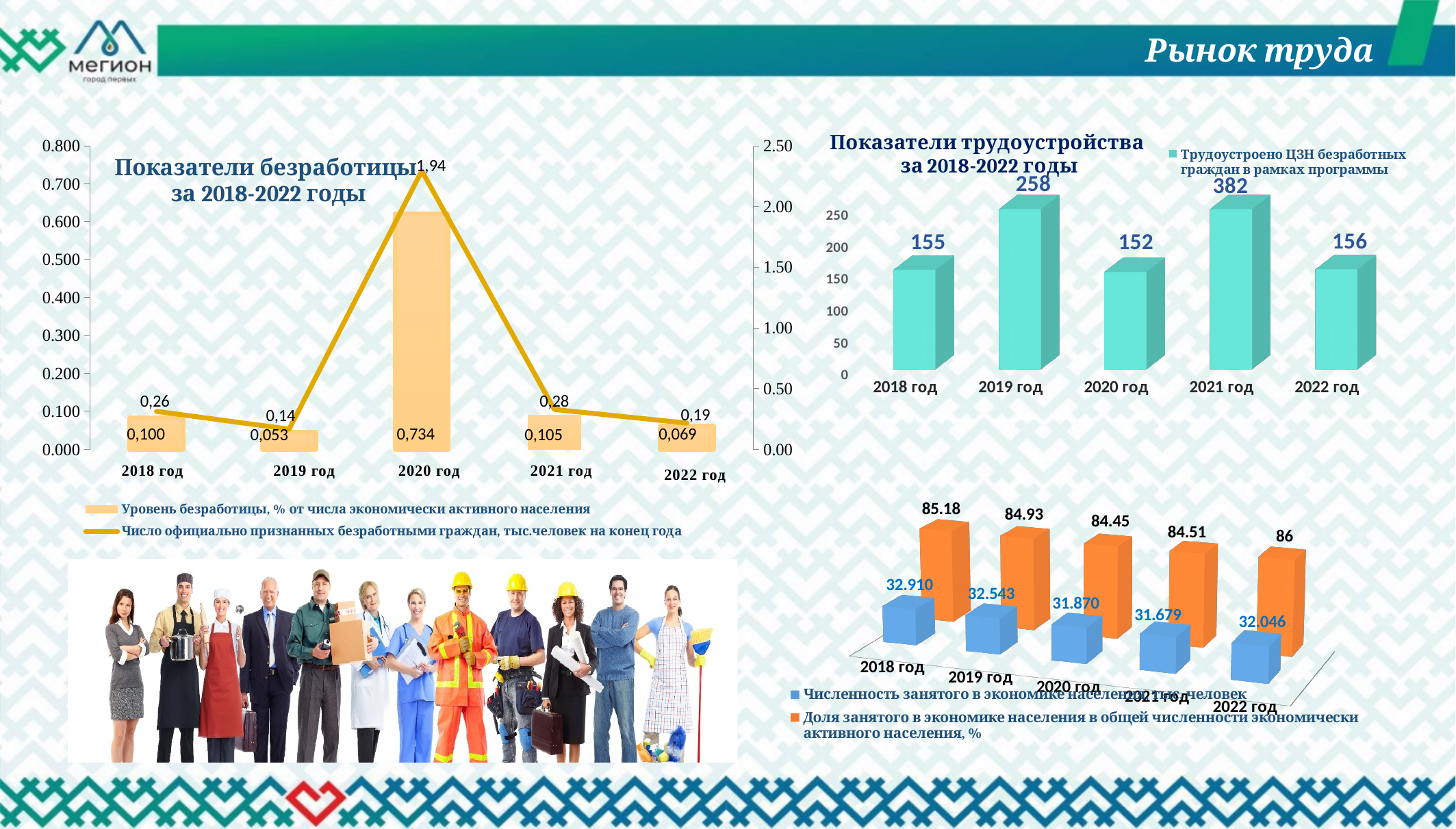
In the chart 'Показатели трудоустройства за 2018-2022 годы', how many years are shown on the x axis? 5 What kind of chart is 'Показатели трудоустройства за 2018-2022 годы'? bar chart In the chart 'Показатели безработицы за 2018-2022 годы', what is the number of officially recognised unemployed citizens (thousand people) for 2019 год? 0,14 In the chart 'Показатели трудоустройства за 2018-2022 годы', which year has the lowest value? 2020 год In the chart 'Показатели безработицы за 2018-2022 годы', which year has the highest unemployment rate? 2020 год In the bottom-right chart, what is the number of people employed in the economy (Численность занятого в экономике населения, тыс.человек) for 2021 год? 31.679 In the chart 'Показатели трудоустройства за 2018-2022 годы', what is the difference between the values for 2021 год and 2019 год? 124 In the chart 'Показатели безработицы за 2018-2022 годы', which year has the lowest number of officially recognised unemployed citizens? 2019 год In the chart 'Показатели безработицы за 2018-2022 годы', what is the unemployment rate (Уровень безработицы) for 2020 год? 0,734 In the bottom-right chart, which year has the highest share of employed population (Доля занятого в экономике населения)? 2022 год In the chart 'Показатели безработицы за 2018-2022 годы', how many series does the legend list? 2 In the chart 'Показатели трудоустройства за 2018-2022 годы', what is the value for 2021 год? 382